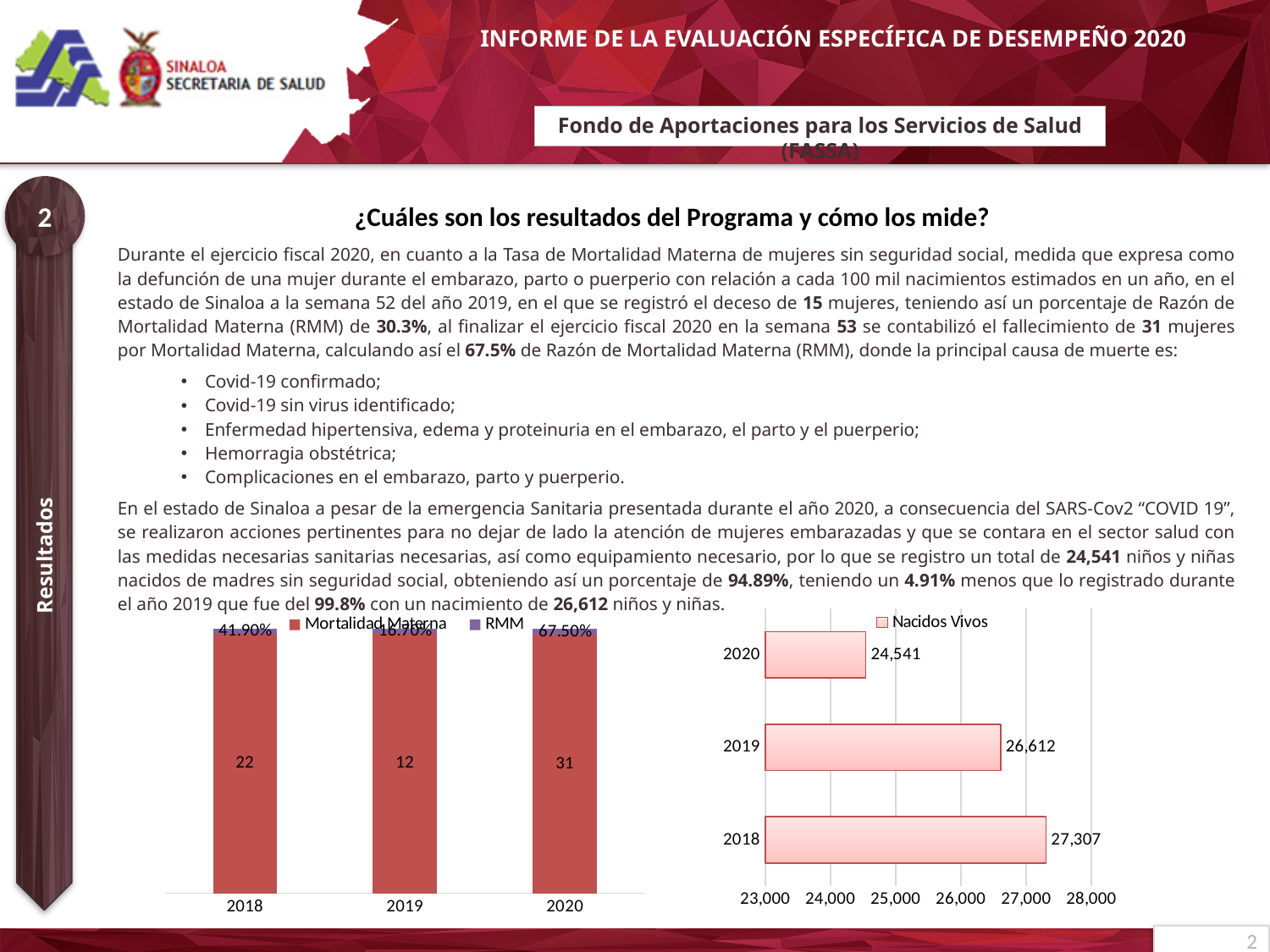
In the left chart, what is the Mortalidad Materna value for 2019? 12 In the left chart, what is the RMM value for 2018? 41.90% In the Nacidos Vivos chart on the right, what is the value for 2018? 27,307 In the Nacidos Vivos chart on the right, which year has the lowest value? 2020 In the left chart, which year has the highest Mortalidad Materna value? 2020 In the Nacidos Vivos chart on the right, what is the difference between the 2018 and 2020 values? 2,766 In the Nacidos Vivos chart on the right, what is the value for 2019? 26,612 In the left chart, what is the Mortalidad Materna value for 2020? 31 How many series does the legend of the left chart list? 2 In the Nacidos Vivos chart on the right, how many years are shown? 3 In the Nacidos Vivos chart on the right, which year has the highest value? 2018 In the Nacidos Vivos chart on the right, do the values rise or fall from 2018 to 2020? fall